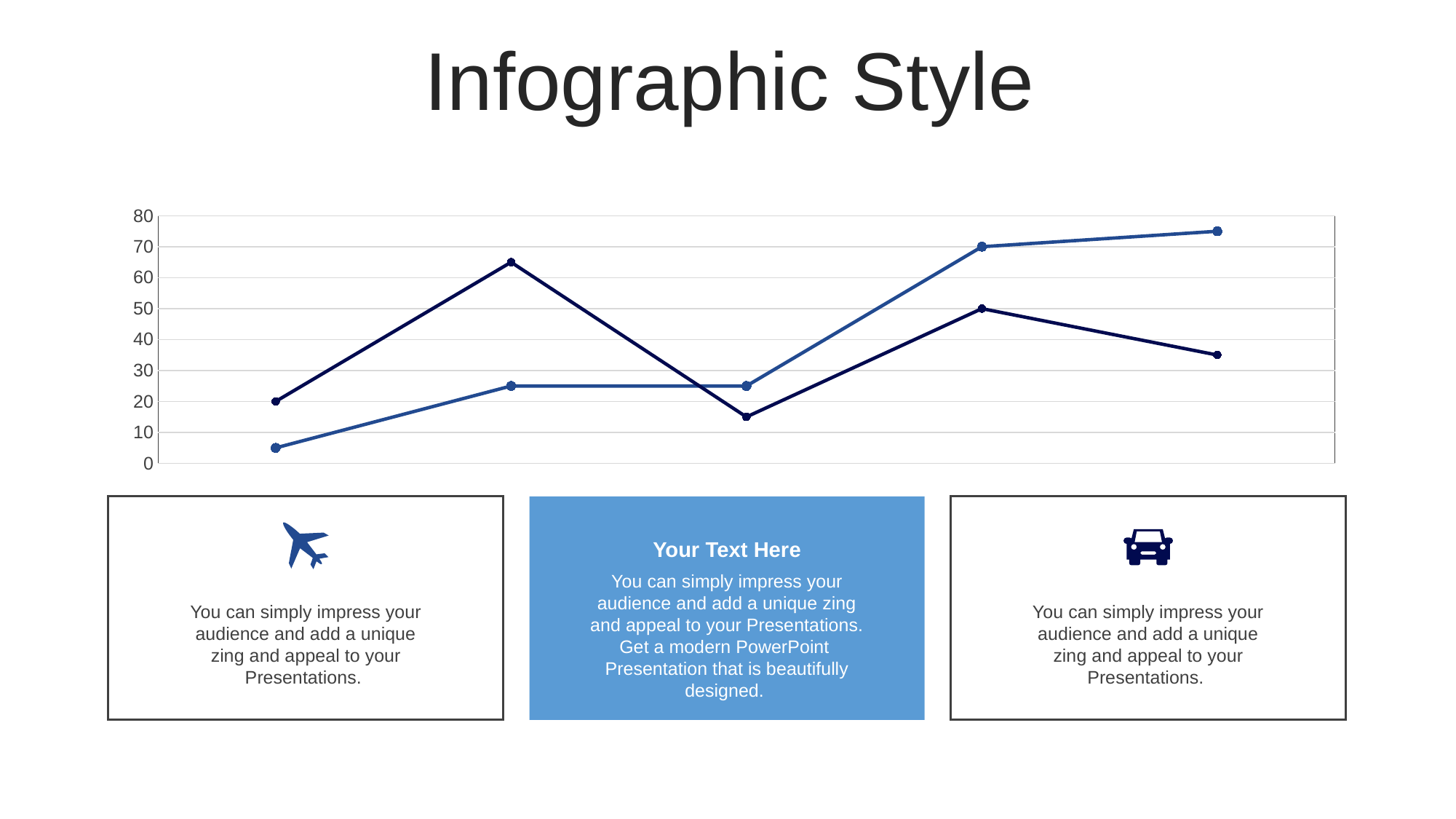
At the last (fifth) point, which line is higher, the dark navy line or the lighter blue line? the lighter blue line Does the lighter blue line rise or fall overall from its first point to its last point? rise Which point on the lighter blue line is the highest? the fifth (last) point What kind of chart is shown on the slide? line chart What is the value of the first point on the dark navy line? 20 What is the value of the fourth point on the lighter blue line? 70 What is the value of the fourth point on the dark navy line? 50 Is the value of the first point on the lighter blue line greater or less than 10? less How many lines are plotted on the chart? 2 Is the value of the second point on the dark navy line greater or less than 60? greater How many data points does each line on the chart have? 5 At the second point, which line is higher, the dark navy line or the lighter blue line? the dark navy line